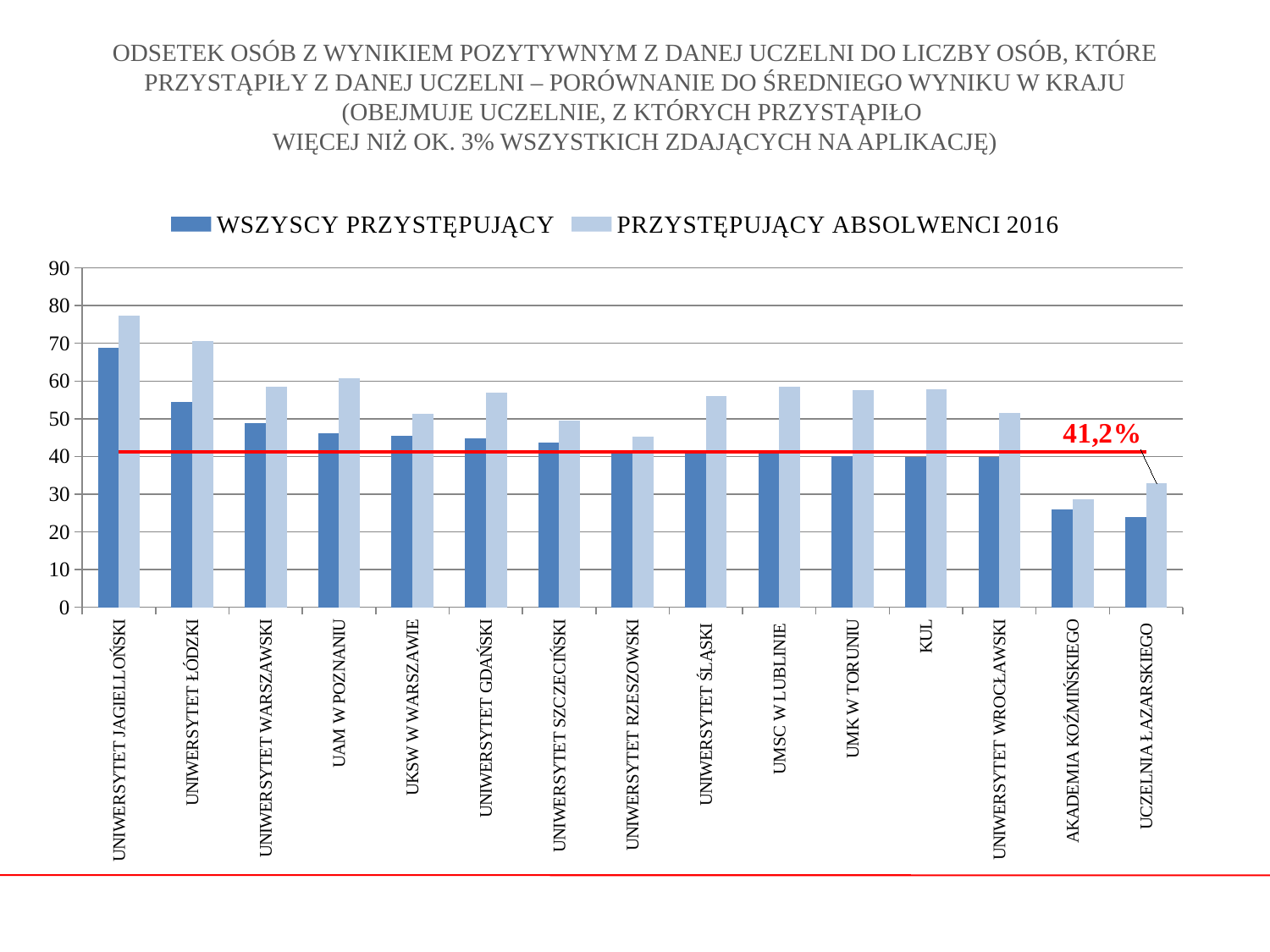
What kind of chart is shown on the slide? bar chart Which university has the lowest value for WSZYSCY PRZYSTĘPUJĄCY? Uczelnia Łazarskiego How many universities (categories) are shown on the x axis? 15 Is the WSZYSCY PRZYSTĘPUJĄCY value for Akademia Koźmińskiego greater or less than 30? less For PRZYSTĘPUJĄCY ABSOLWENCI 2016, which is larger: Uniwersytet Śląski or Uniwersytet Rzeszowski? Uniwersytet Śląski Is the WSZYSCY PRZYSTĘPUJĄCY value for Uniwersytet Jagielloński greater or less than 60? greater What value is labelled on the red horizontal line across the chart? 41,2% How many series does the legend list? 2 Do the WSZYSCY PRZYSTĘPUJĄCY values rise or fall from left to right along the x axis? fall Which university has the highest value for WSZYSCY PRZYSTĘPUJĄCY? Uniwersytet Jagielloński Is the PRZYSTĘPUJĄCY ABSOLWENCI 2016 value for Uniwersytet Gdański greater or less than 60? less Which university has the highest value for PRZYSTĘPUJĄCY ABSOLWENCI 2016? Uniwersytet Jagielloński